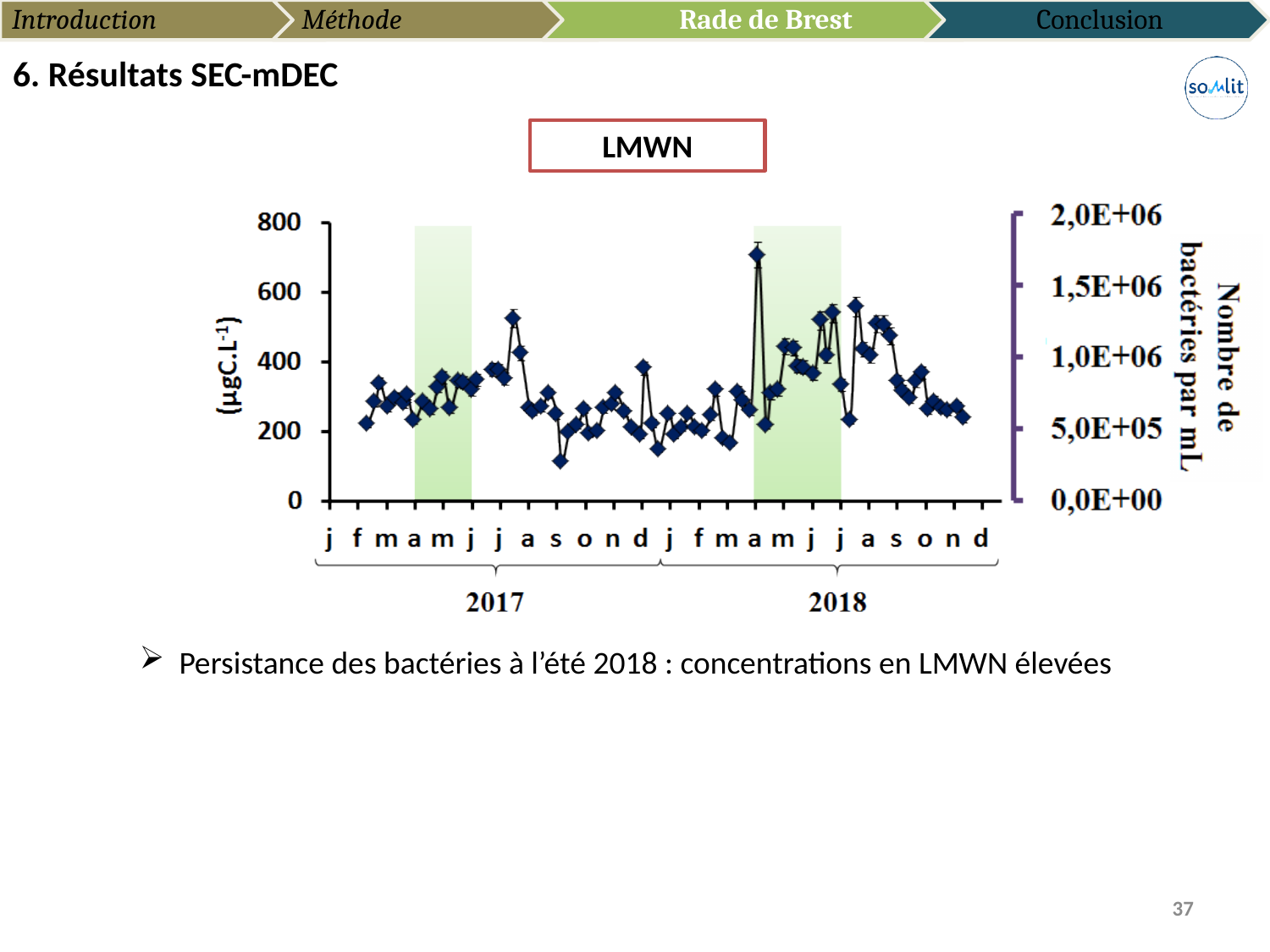
What is the title shown in the box above the chart? LMWN What is the highest tick value on the left vertical axis? 800 Which years are labelled along the x axis? 2017 and 2018 Which is larger, the highest peak in 2017 or the highest peak in 2018? 2018 What kind of chart is shown on the slide? line chart How many green shaded periods are highlighted on the chart? 2 What is the highest tick value on the right vertical axis? 2,0E+06 Is the lowest value of the series in 2017 greater or less than 200? less In which year does the highest peak of the plotted series occur? 2018 How many years are covered along the x axis? 2 What is the label of the right-hand vertical axis? Nombre de bactéries par mL Is the highest value of the series in 2018 greater or less than 600? greater